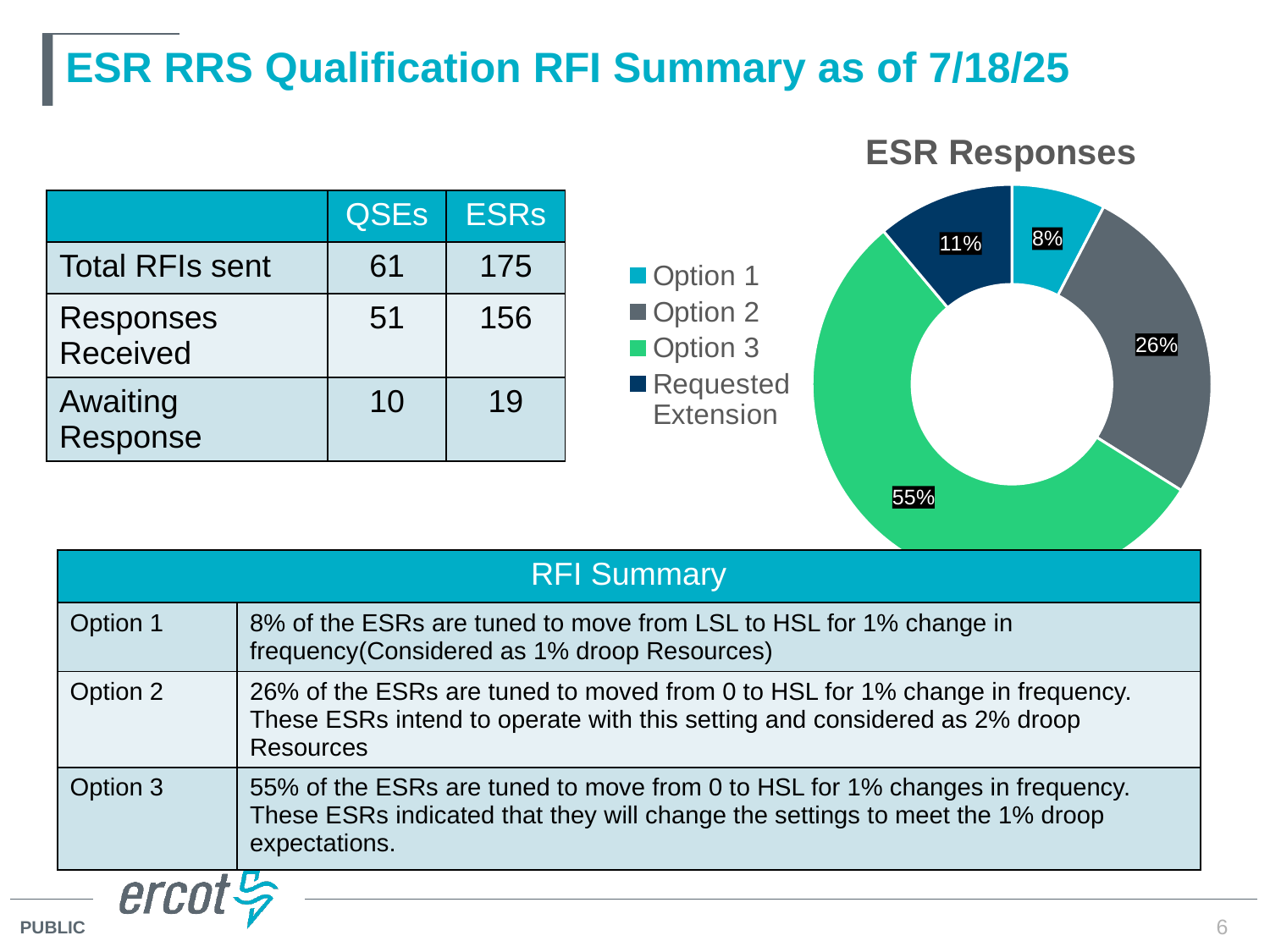
In the ESR Responses chart, which is larger: Option 2 or Requested Extension? Option 2 What type of chart is the ESR Responses chart? Pie chart (doughnut) What share of the ESR Responses chart is Option 3? 55% What is the difference in percentage points between Requested Extension and Option 1 in the ESR Responses chart? 3 What share of the ESR Responses chart is Requested Extension? 11% Which category has the smallest slice in the ESR Responses chart? Option 1 What share of the ESR Responses chart is Option 2? 26% What is the difference in percentage points between Option 3 and Option 2 in the ESR Responses chart? 29 Which category has the largest slice in the ESR Responses chart? Option 3 How many categories does the ESR Responses chart show? 4 What is the title of the chart on the slide? ESR Responses